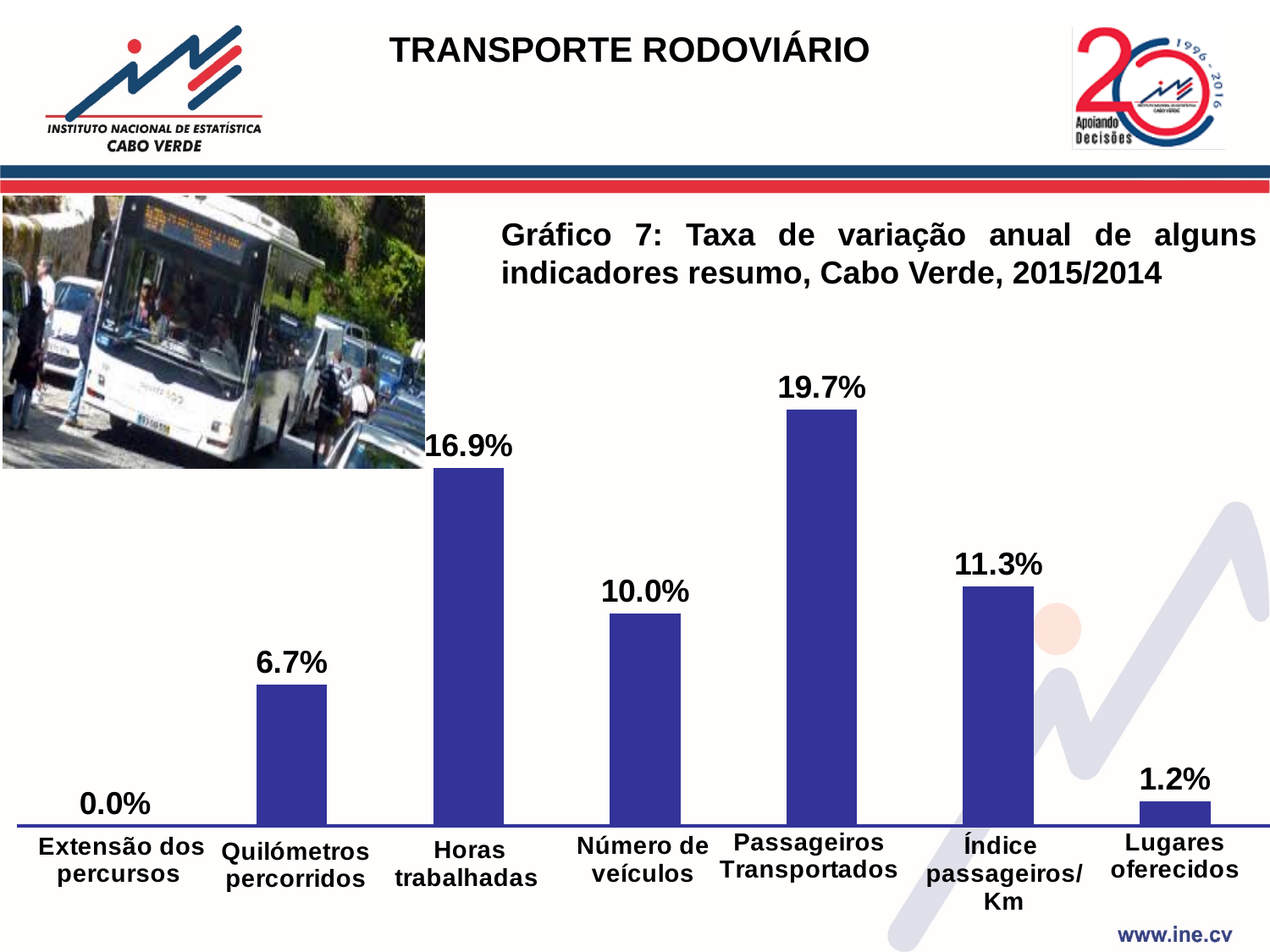
What is the value shown for Quilómetros percorridos? 6.7% Which indicator has the lowest annual variation rate? Extensão dos percursos What is the title of the chart? Gráfico 7: Taxa de variação anual de alguns indicadores resumo, Cabo Verde, 2015/2014 What is the value shown for Horas trabalhadas? 16.9% Which is larger, the value for Número de veículos or the value for Índice passageiros/Km? Índice passageiros/Km What is the difference between the values for Horas trabalhadas and Quilómetros percorridos? 10.2% What is the value shown for Lugares oferecidos? 1.2% How many indicators are shown in the chart? 7 What is the annual variation rate for Passageiros Transportados? 19.7% Which indicator has the highest annual variation rate? Passageiros Transportados What is the difference between the values for Passageiros Transportados and Índice passageiros/Km? 8.4% What type of chart is shown on the slide? Bar chart